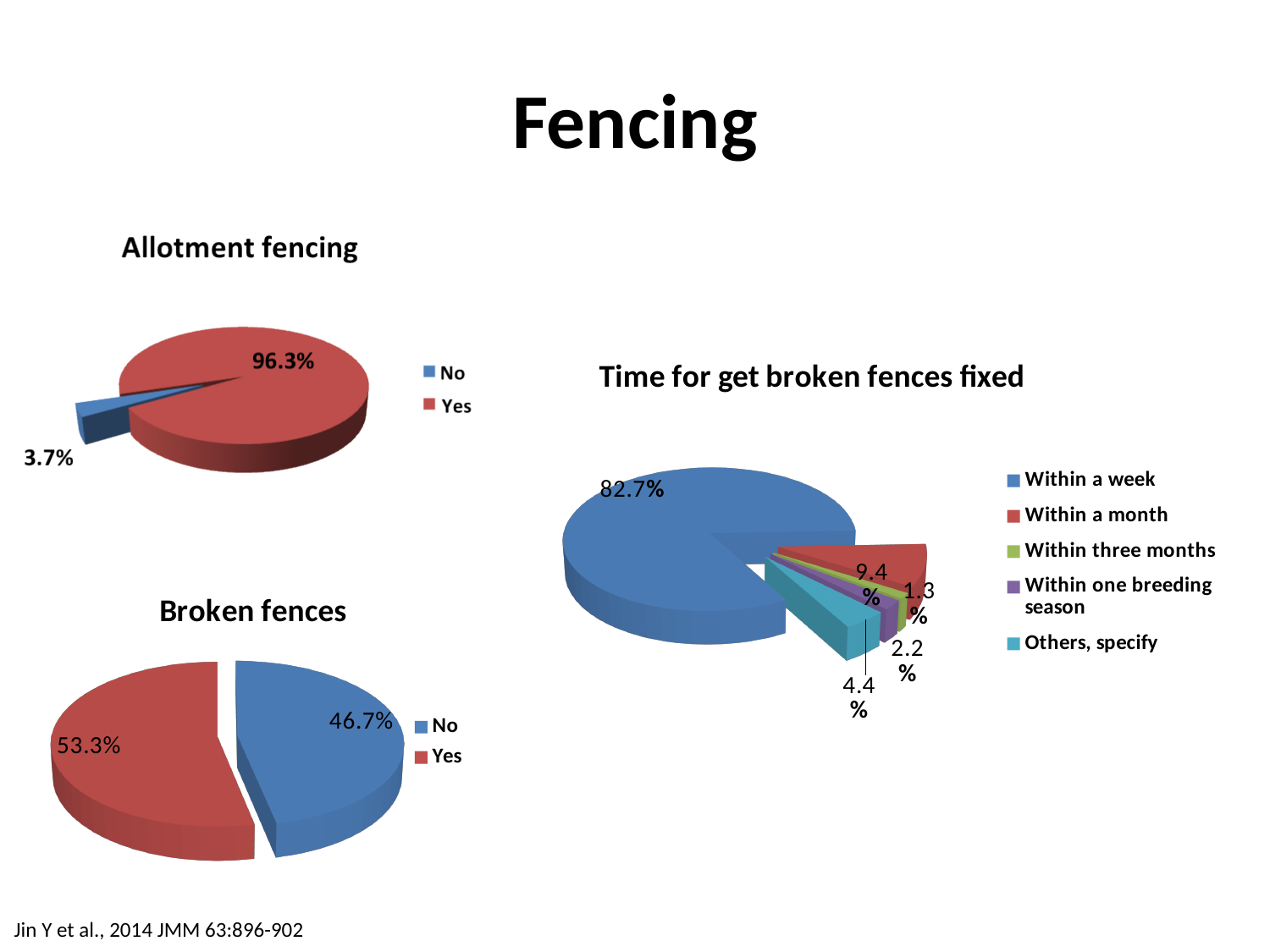
In the 'Allotment fencing' chart, what share of the pie is 'No'? 3.7% In the 'Time for get broken fences fixed' chart, how many categories does the legend list? 5 In the 'Broken fences' chart, which category is larger, 'Yes' or 'No'? Yes In the 'Time for get broken fences fixed' chart, which category has the smallest share? Within three months In the 'Time for get broken fences fixed' chart, what is the value for 'Within a week'? 82.7% In the 'Broken fences' chart, what is the difference between 'Yes' and 'No'? 6.6% In the 'Broken fences' chart, what is the value for 'Yes'? 53.3% What kind of chart is 'Time for get broken fences fixed'? Pie chart In the 'Allotment fencing' chart, what colour is the 'Yes' slice? Red In the 'Broken fences' chart, what is the value for 'No'? 46.7% In the 'Time for get broken fences fixed' chart, what is the value for 'Within a month'? 9.4% In the 'Allotment fencing' chart, what share of the pie is 'Yes'? 96.3%